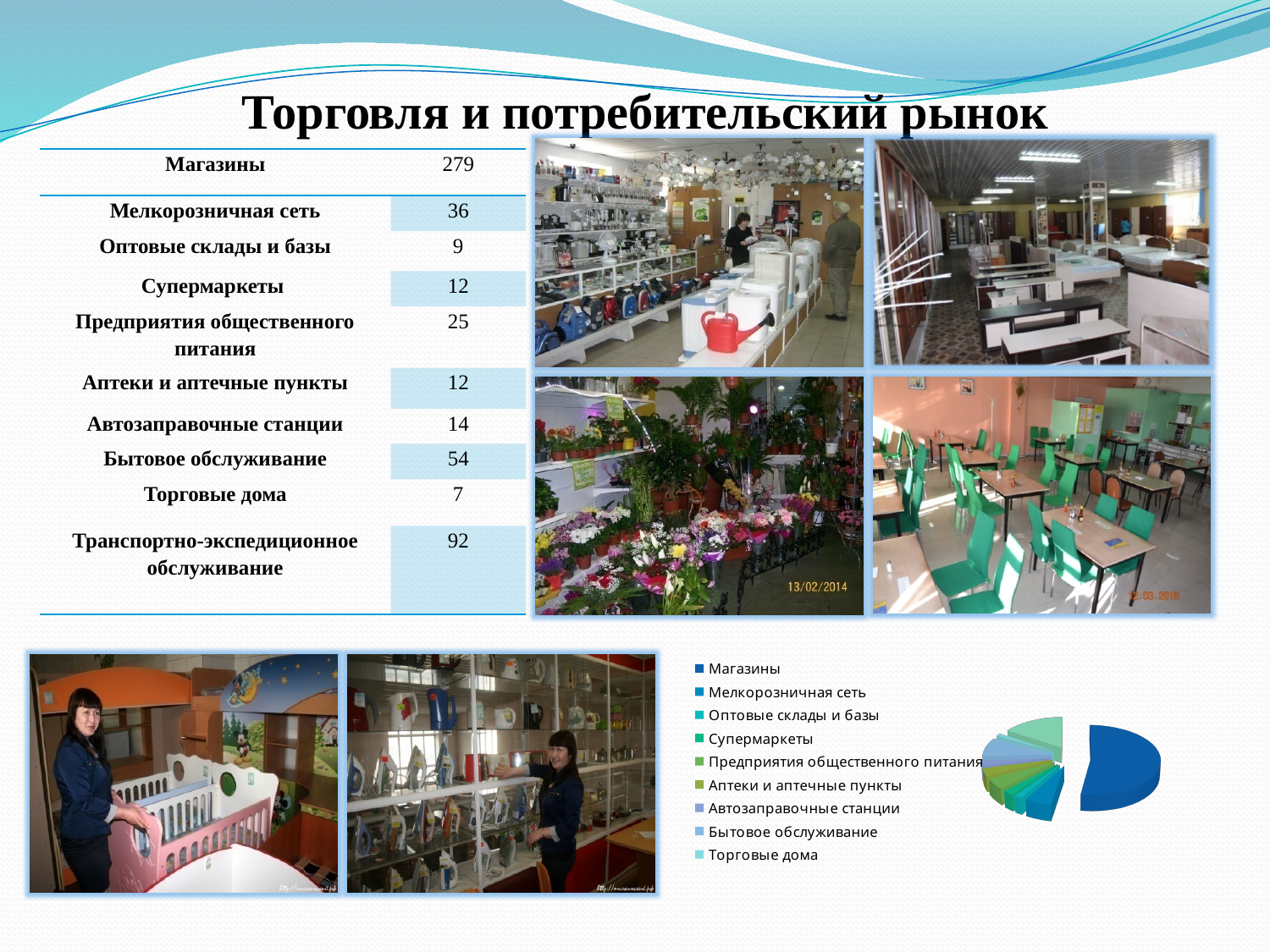
How many categories does the legend of the pie chart list? 9 Which category's slice is separated (exploded) from the rest of the pie chart? Магазины Among the categories listed in the pie chart legend, which has the lowest value in the table? Торговые дома Which is larger according to the table: Бытовое обслуживание or Мелкорозничная сеть? Бытовое обслуживание According to the table on the slide, what is the value for Магазины? 279 What is the difference between the values for Предприятия общественного питания and Супермаркеты in the table? 13 According to the table on the slide, what is the value for Торговые дома? 7 According to the table on the slide, what is the value for Бытовое обслуживание? 54 What kind of chart is shown at the bottom right of the slide? pie chart What is the difference between the values for Магазины and Мелкорозничная сеть in the table? 243 What colour is the slice for Магазины in the pie chart? dark blue Which category corresponds to the largest slice of the pie chart? Магазины